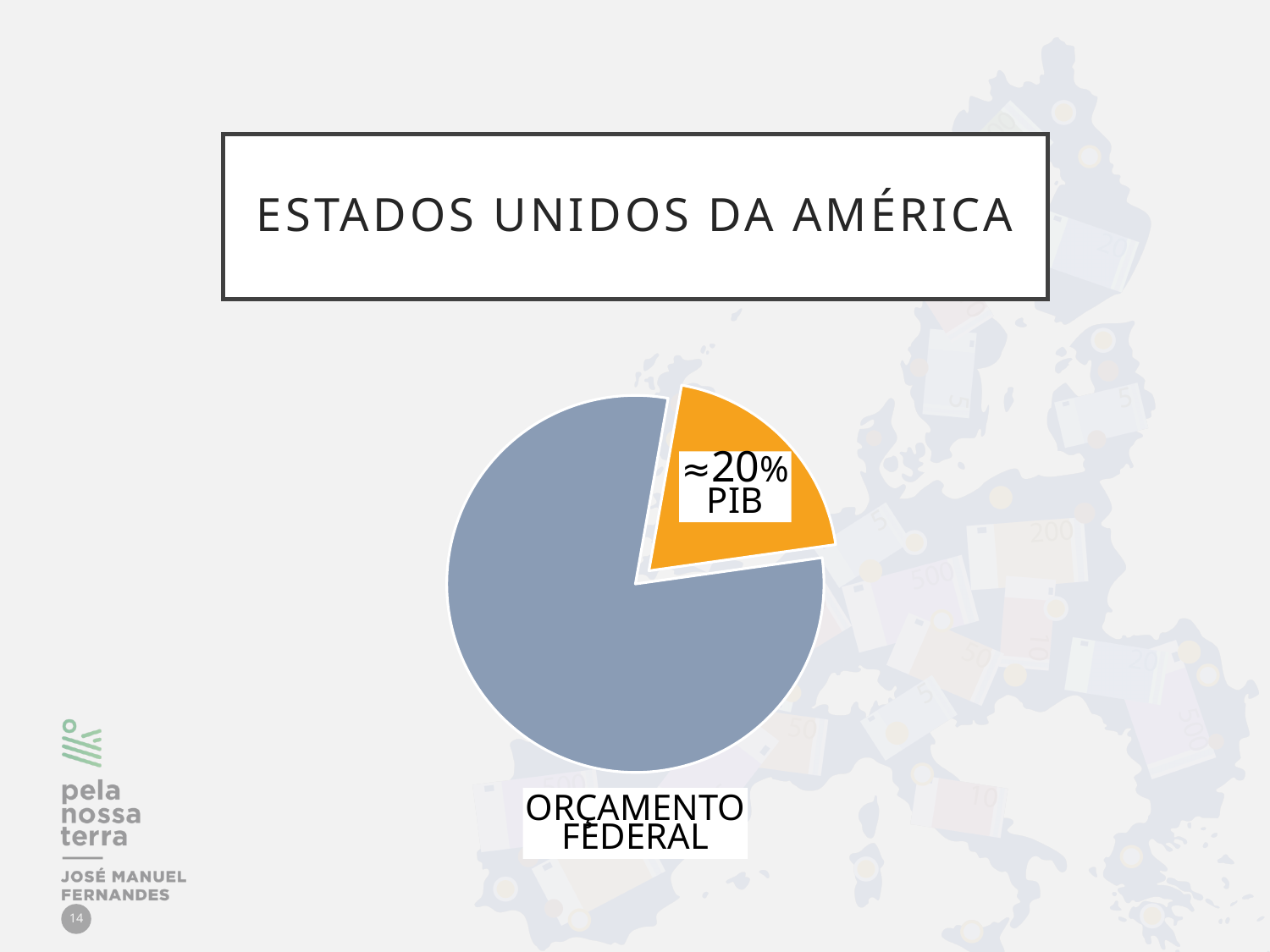
Which slice of the pie chart is the smallest? ≈20% PIB What share of the pie does the orange slice represent, as printed on the slide? ≈20% How many slices does the pie chart have? 2 What label is printed on the orange slice of the pie chart? ≈20% PIB Which slice of the pie chart is the largest? ORÇAMENTO FEDERAL What kind of chart is shown on the slide? pie chart What colour is the ORÇAMENTO FEDERAL slice of the pie chart? blue-grey What is the title shown above the pie chart? ESTADOS UNIDOS DA AMÉRICA Which slice of the pie chart is larger, ORÇAMENTO FEDERAL or the ≈20% PIB slice? ORÇAMENTO FEDERAL